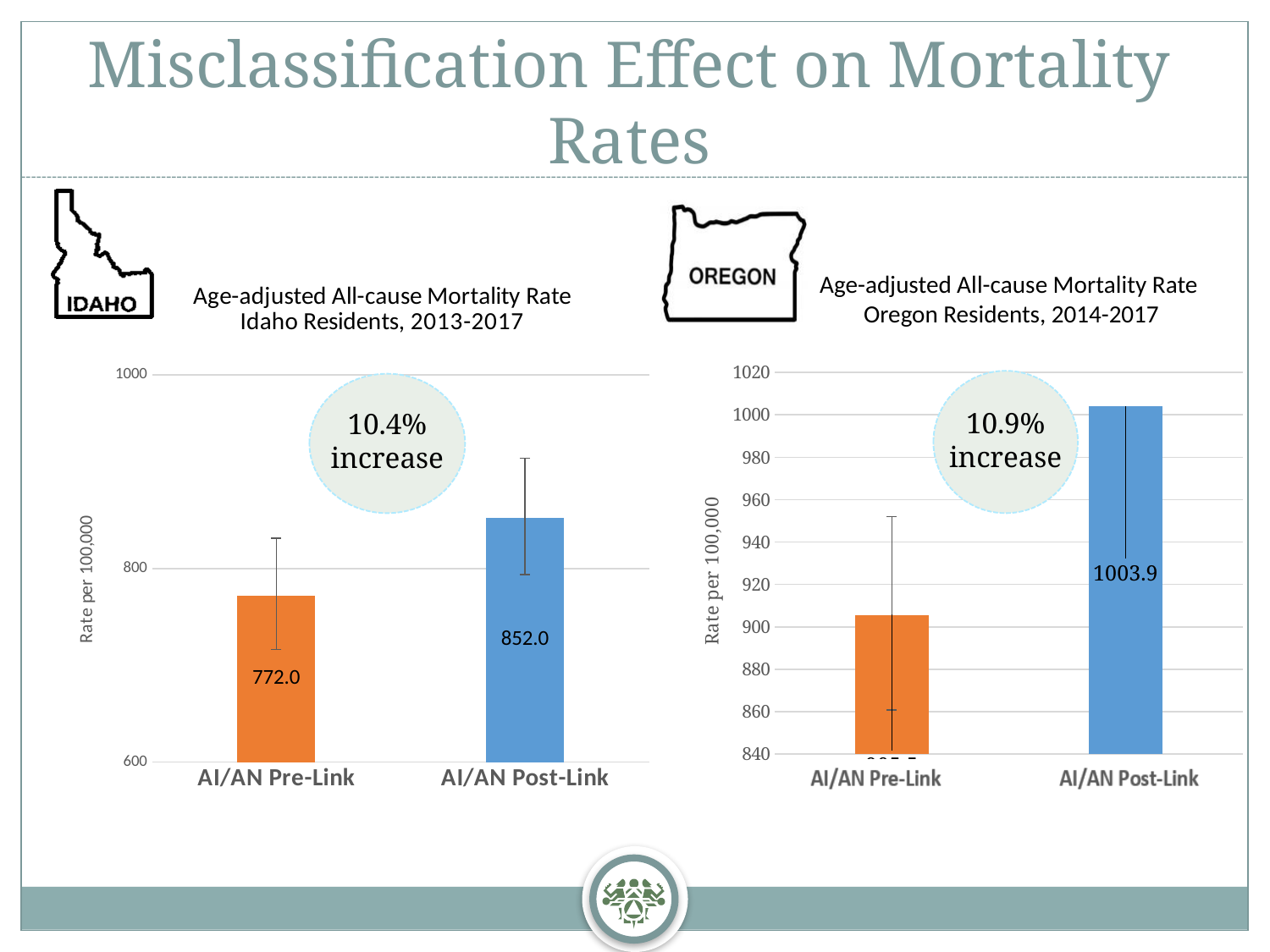
In the Idaho chart, which category has the higher mortality rate, AI/AN Pre-Link or AI/AN Post-Link? AI/AN Post-Link In the Oregon chart, is the value for AI/AN Pre-Link greater or less than 940? less In the Oregon chart, which category has the lowest mortality rate? AI/AN Pre-Link In the Idaho chart, what is the age-adjusted all-cause mortality rate for AI/AN Pre-Link? 772.0 What percentage increase is annotated on the Oregon chart? 10.9% How many categories are shown in the Oregon chart? 2 In the Idaho chart, what is the age-adjusted all-cause mortality rate for AI/AN Post-Link? 852.0 In the Idaho chart, what is the difference between the AI/AN Post-Link and AI/AN Pre-Link rates? 80.0 In the Oregon chart, is the value for AI/AN Post-Link greater or less than 980? greater In the Oregon chart, what is the age-adjusted all-cause mortality rate for AI/AN Post-Link? 1003.9 What is the y-axis label of the Idaho chart? Rate per 100,000 What kind of chart is the Idaho chart? bar chart